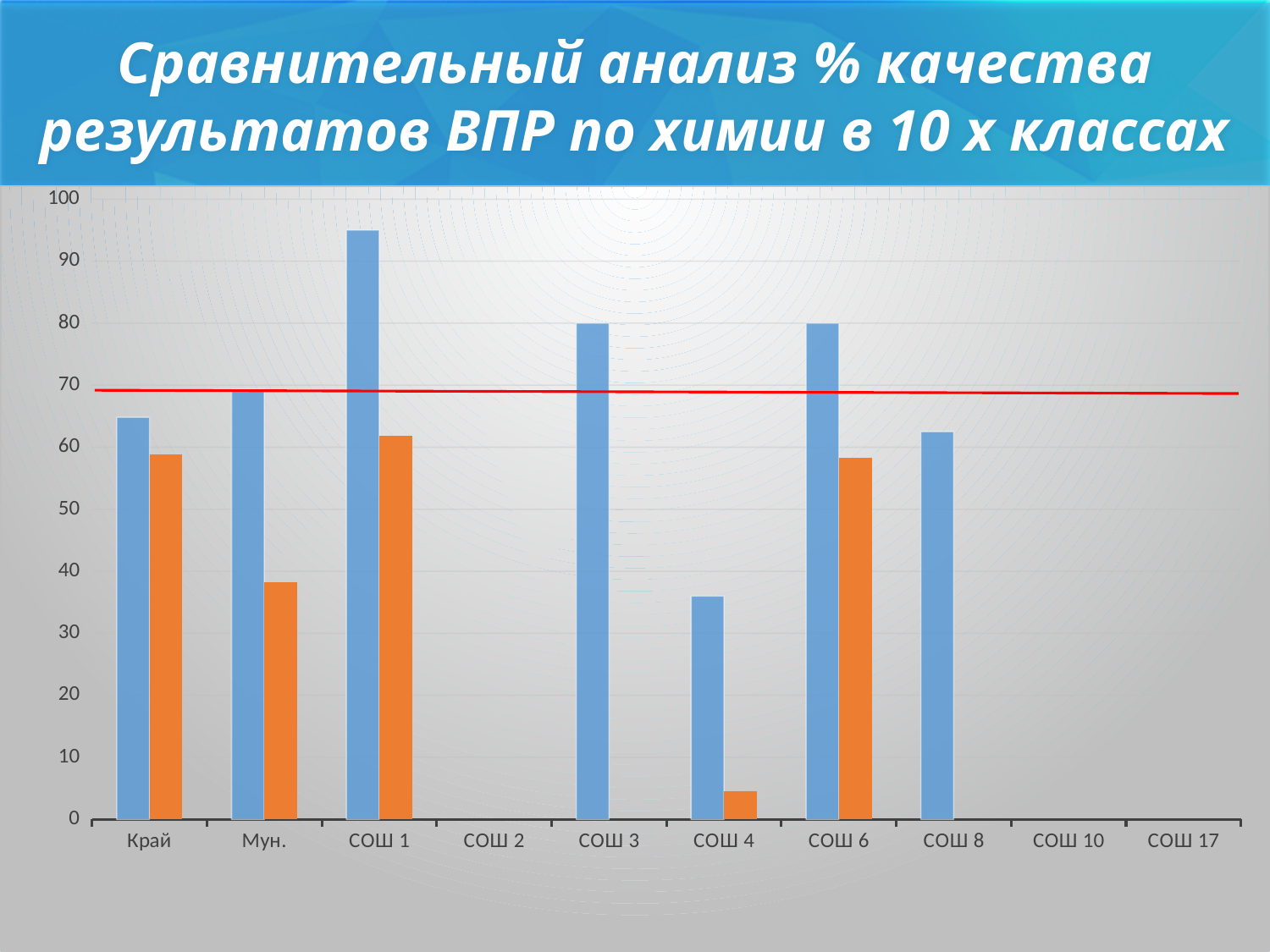
Is the value of the orange bar for Мун. greater or less than 30? greater What colour is the horizontal line drawn across the chart? red What kind of chart is shown on the slide? bar chart Which category has the tallest blue bar? СОШ 1 Is the value of the blue bar for СОШ 1 greater or less than 90? greater Which category has the shortest visible orange bar? СОШ 4 How many categories are shown on the x axis of the chart? 10 Which blue bar is taller, СОШ 1 or СОШ 3? СОШ 1 Is the value of the blue bar for СОШ 4 greater or less than 40? less Among the categories that have a visible blue bar, which has the shortest blue bar? СОШ 4 For Край, which bar is taller, the blue one or the orange one? the blue one